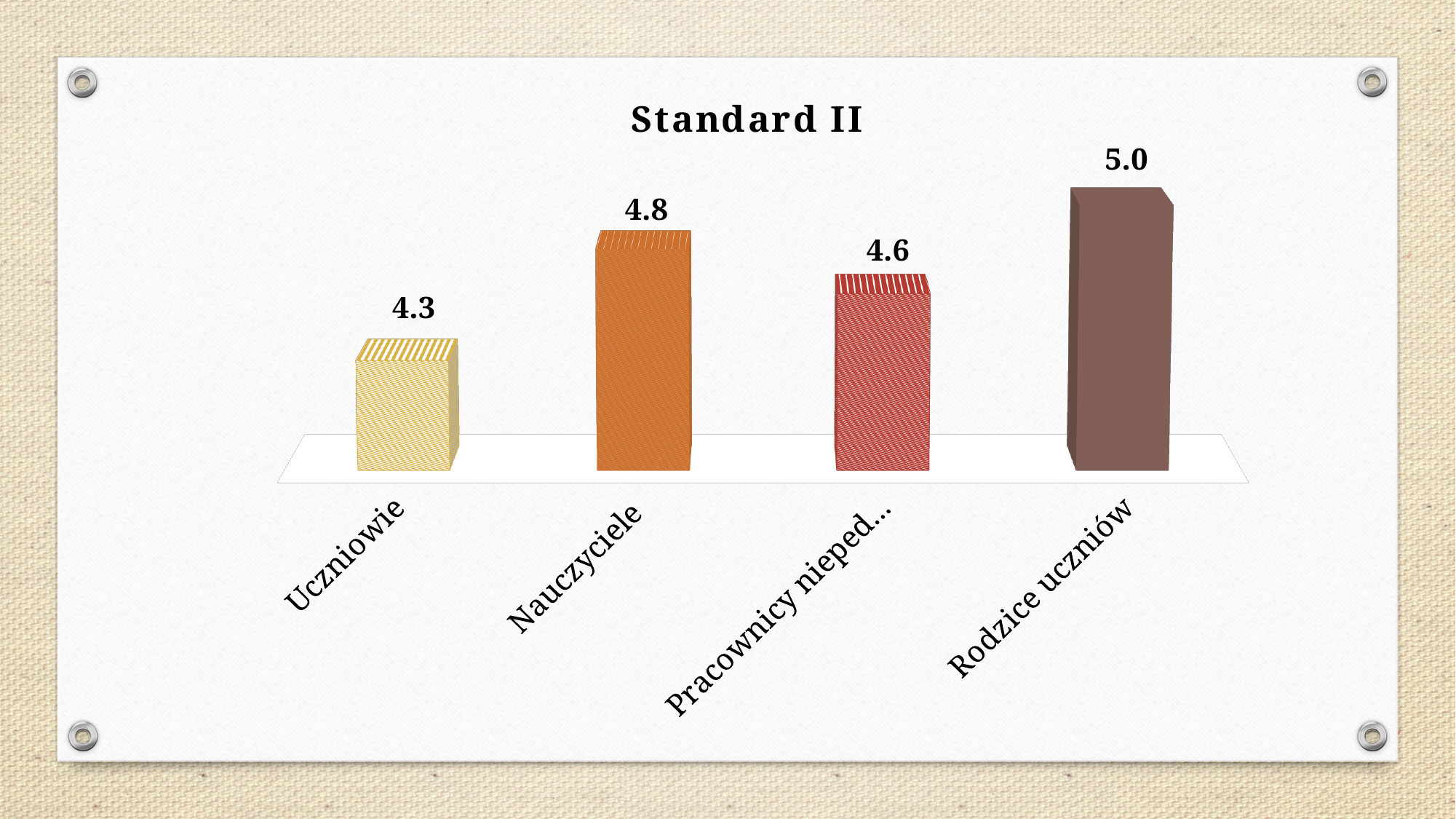
What is the value for Rodzice uczniów? 5.0 What is the value for Nauczyciele? 4.8 Which is larger, the value for Nauczyciele or the value for Uczniowie? Nauczyciele What is the title of the chart? Standard II How many categories are shown in the chart? 4 Which category has the lowest value? Uczniowie What kind of chart is shown on the slide? Bar chart What is the value for Uczniowie? 4.3 What is the difference between the values for Rodzice uczniów and Uczniowie? 0.7 Which category has the highest value? Rodzice uczniów What is the value for the third bar, labelled Pracownicy nieped...? 4.6 What is the difference between the values for Nauczyciele and the third bar (Pracownicy nieped...)? 0.2